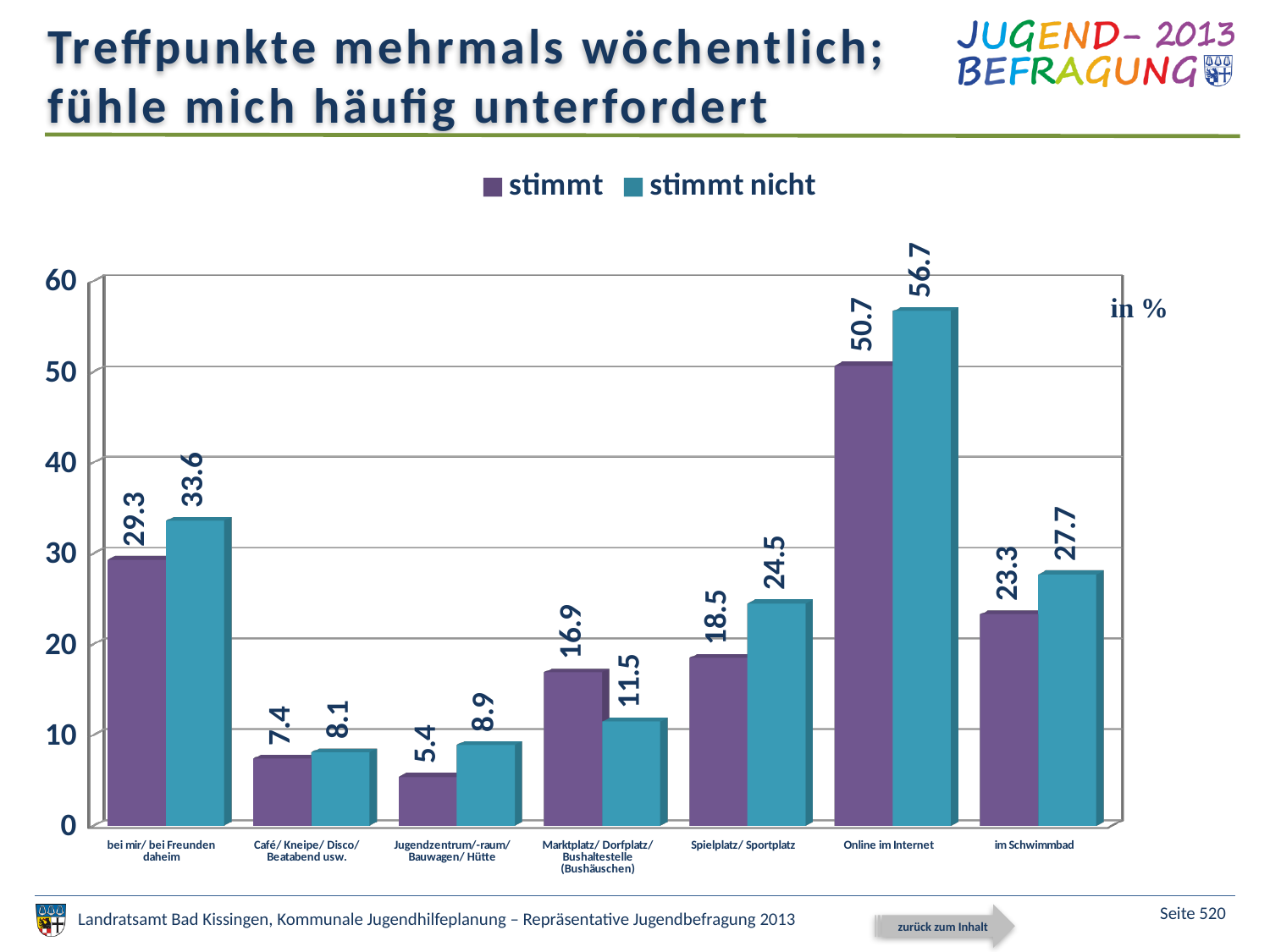
What kind of chart is shown on the slide? bar chart Which is larger at "Marktplatz/ Dorfplatz/ Bushaltestelle (Bushäuschen)": "stimmt" or "stimmt nicht"? stimmt What is the value for "stimmt nicht" at "Spielplatz/ Sportplatz"? 24.5 What is the difference between "stimmt nicht" and "stimmt" at "Online im Internet"? 6.0 Is the value for "stimmt nicht" at "bei mir/ bei Freunden daheim" greater or less than 30? greater What is the value for "stimmt" at "Jugendzentrum/-raum/ Bauwagen/ Hütte"? 5.4 Which category has the lowest value for "stimmt"? Jugendzentrum/-raum/ Bauwagen/ Hütte What unit is indicated for the values in the chart? in % What is the value for "stimmt" at "Online im Internet"? 50.7 How many categories are shown on the x axis? 7 Which category has the highest value for "stimmt nicht"? Online im Internet How many series does the legend list? 2